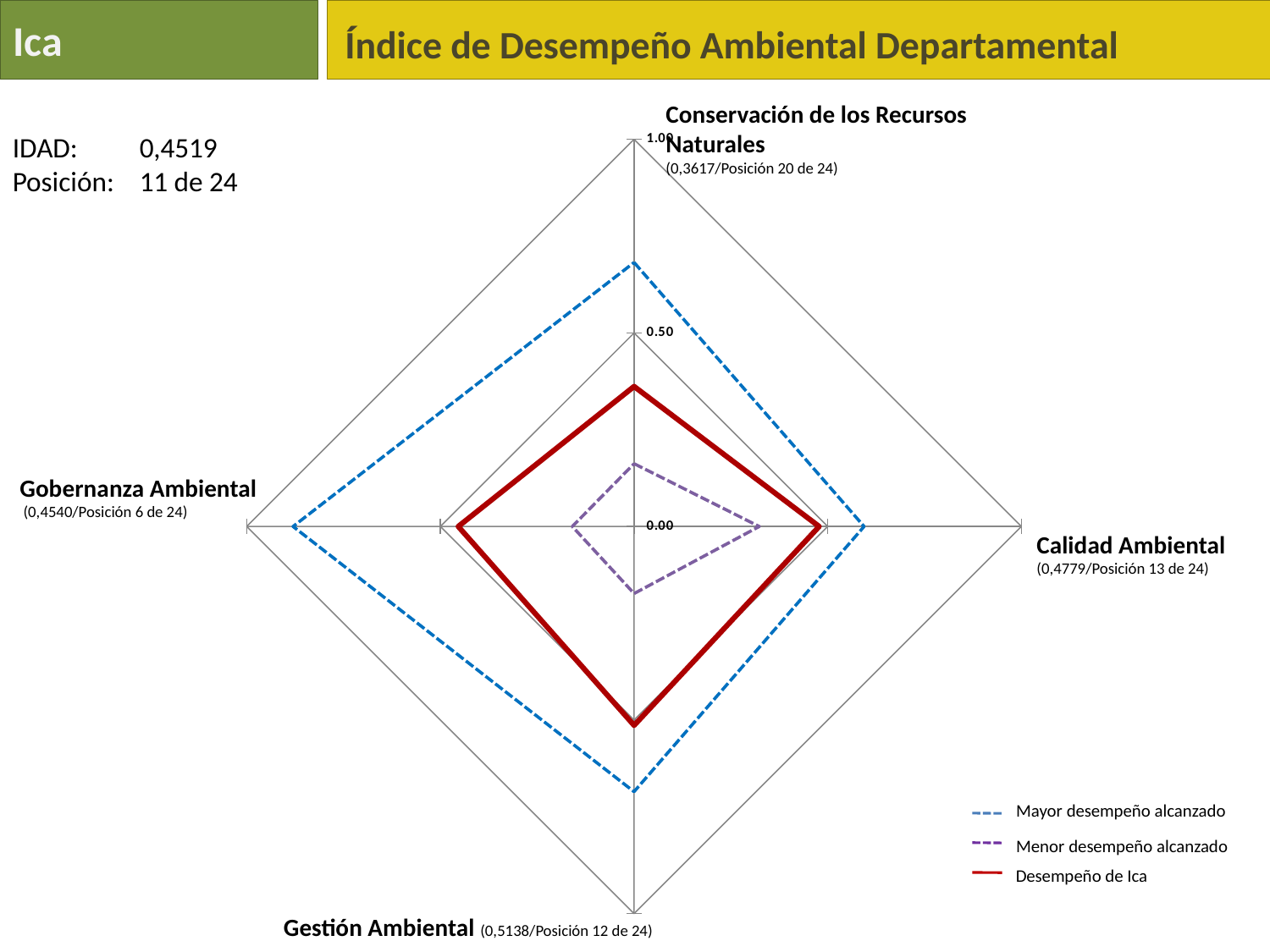
What is Ica's value for Gestión Ambiental? 0,5138 In which category does Ica have its highest value? Gestión Ambiental What colour is the line for Desempeño de Ica? Red In which category does Ica have its lowest value? Conservación de los Recursos Naturales What kind of chart is shown on the slide? Radar chart What is Ica's value for Calidad Ambiental? 0,4779 Is the Mayor desempeño alcanzado value for Gestión Ambiental greater or less than 0.50? greater What is Ica's value for Conservación de los Recursos Naturales? 0,3617 What is the difference between Ica's Gestión Ambiental value and its Conservación de los Recursos Naturales value? 0,1521 Which is larger for Ica: Calidad Ambiental or Gobernanza Ambiental? Calidad Ambiental How many axes (categories) does the radar chart have? 4 How many series does the legend list? 3